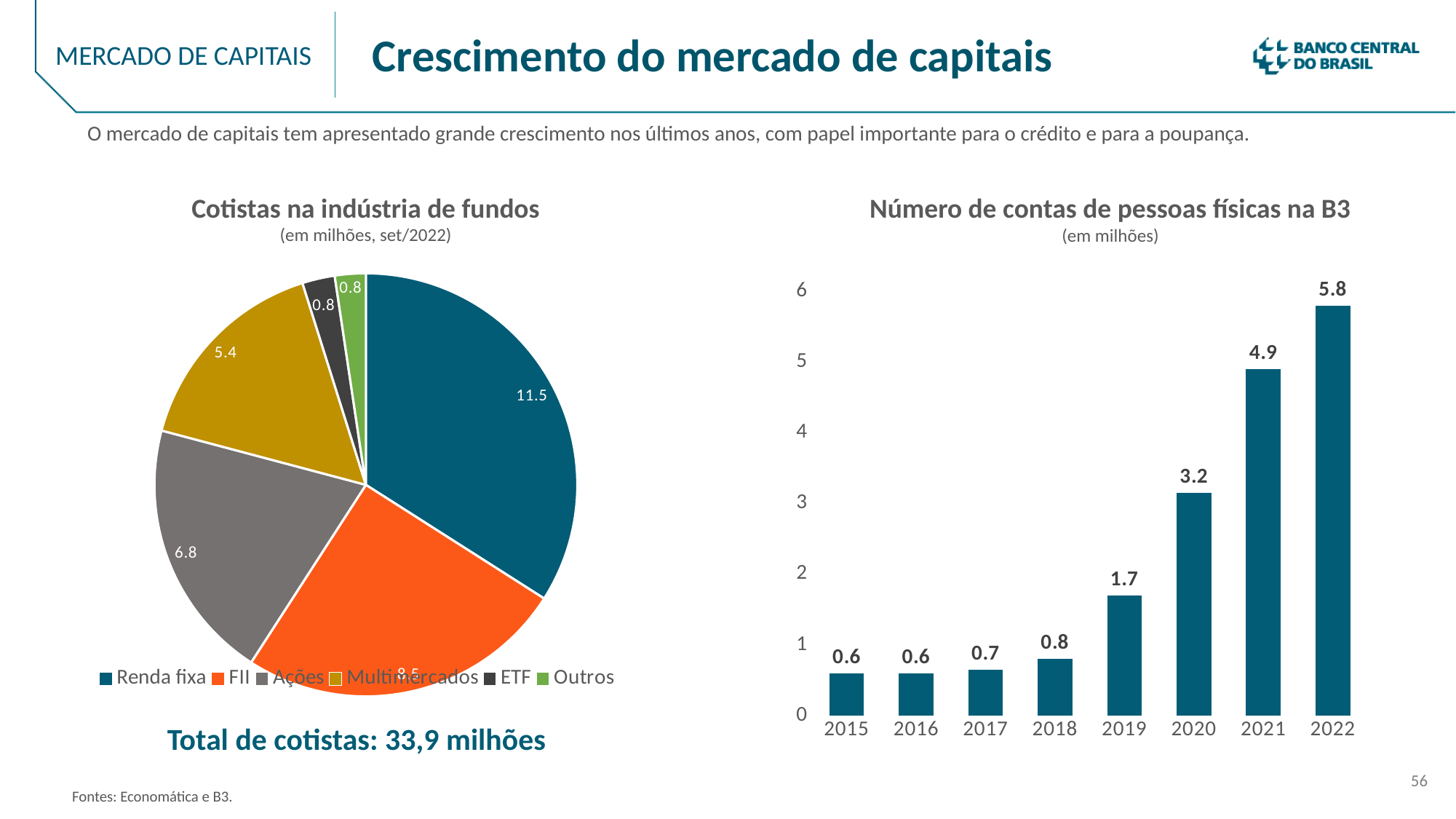
What kind of chart is 'Número de contas de pessoas físicas na B3'? bar chart In the chart 'Número de contas de pessoas físicas na B3', what is the value for 2022? 5.8 In the chart 'Número de contas de pessoas físicas na B3', how many years are shown on the x axis? 8 In the chart 'Número de contas de pessoas físicas na B3', what is the difference between the values for 2022 and 2021? 0.9 In the pie chart 'Cotistas na indústria de fundos', what is the value for Renda fixa? 11.5 In the chart 'Número de contas de pessoas físicas na B3', which year has the highest value? 2022 In the pie chart 'Cotistas na indústria de fundos', which is larger, Multimercados or Ações? Ações In the pie chart 'Cotistas na indústria de fundos', which category has the largest slice? Renda fixa How many categories does the legend of the pie chart 'Cotistas na indústria de fundos' list? 6 In the chart 'Número de contas de pessoas físicas na B3', what is the value for 2019? 1.7 In the pie chart 'Cotistas na indústria de fundos', what is the value for Ações? 6.8 In the chart 'Número de contas de pessoas físicas na B3', do the values rise or fall from 2015 to 2022? rise